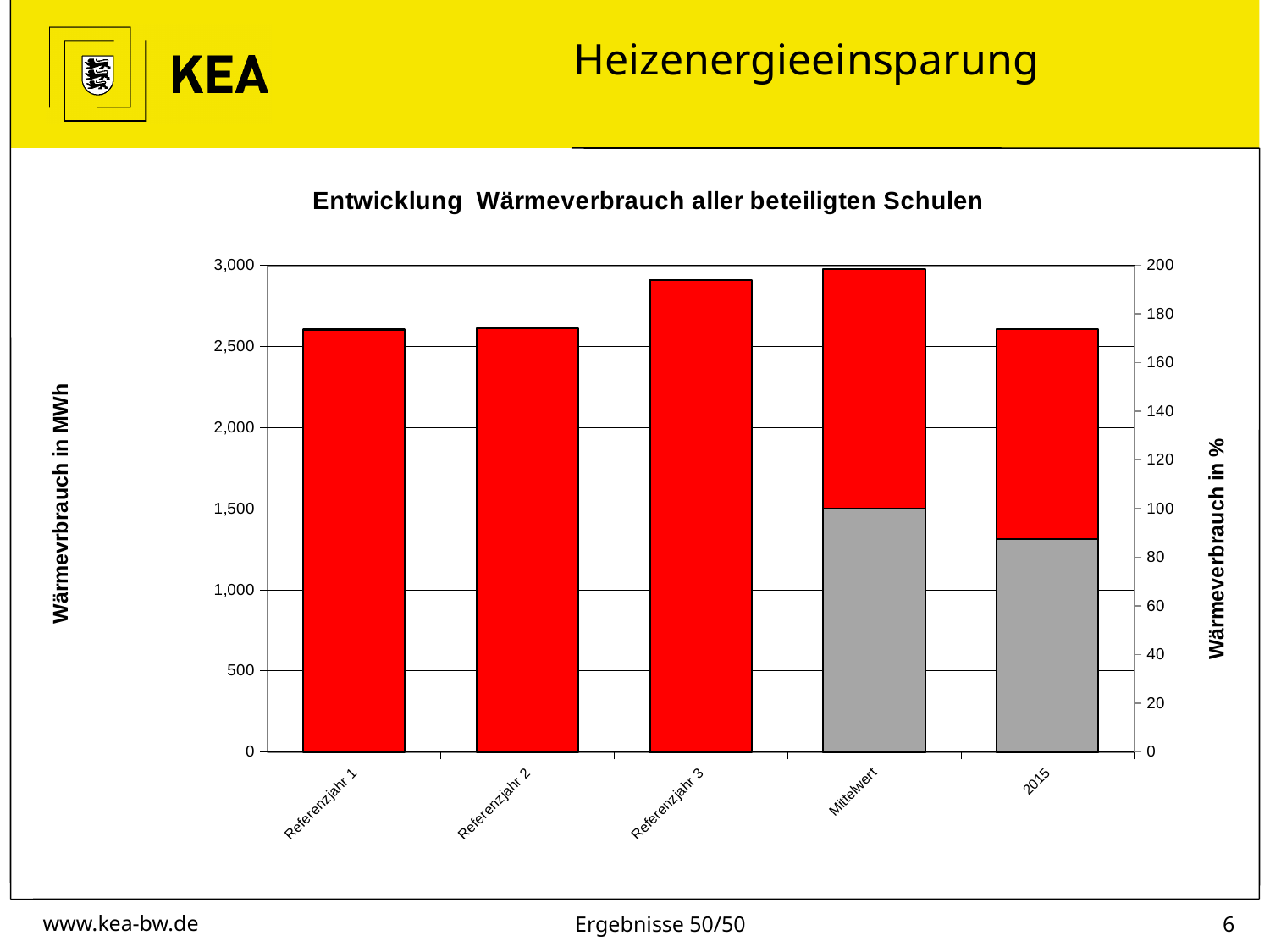
Which red bar is taller, Referenzjahr 3 or Referenzjahr 1? Referenzjahr 3 Is the red bar for Mittelwert greater or less than 3,000 MWh? less Is the red bar for Referenzjahr 1 greater or less than 2,500 MWh? greater What is the title of the chart? Entwicklung Wärmeverbrauch aller beteiligten Schulen What value on the right axis (Wärmeverbrauch in %) does the grey bar for Mittelwert reach? 100 Is the grey bar for 2015 greater or less than 80 on the right axis (Wärmeverbrauch in %)? greater Which categories have a grey bar in addition to the red bar? Mittelwert and 2015 Which category has the tallest red bar? Mittelwert What kind of chart is shown on the slide? bar chart How many categories are shown on the x axis of the chart? 5